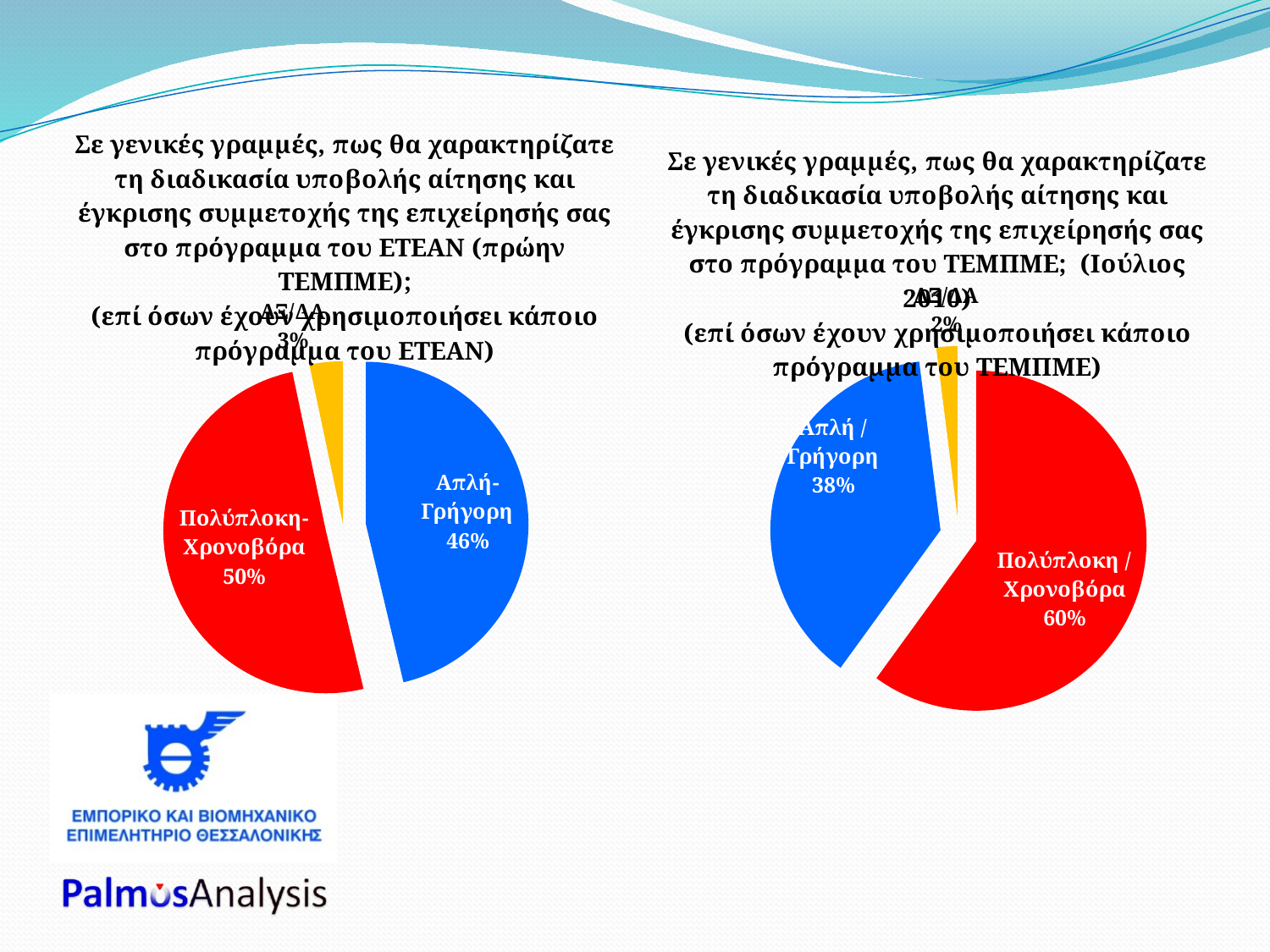
Which is larger: the Απλή-Γρήγορη share in the left chart (ETEAN) or the Απλή / Γρήγορη share in the right chart (ΤΕΜΠΜΕ)? Left chart (ETEAN), 46% In the right pie chart (ΤΕΜΠΜΕ programme), which category has the largest slice? Πολύπλοκη / Χρονοβόρα In the left pie chart (ETEAN programme), what is the difference in percentage points between Πολύπλοκη-Χρονοβόρα and Απλή-Γρήγορη? 4 percentage points What type of chart is used on this slide? Pie chart In the left pie chart (ETEAN programme), which category has the smallest slice? ΔΞ/ΔΑ In the right pie chart (ΤΕΜΠΜΕ programme), what share of respondents answered Απλή / Γρήγορη? 38% How many slices does the left pie chart (ETEAN programme) have? 3 In the left pie chart (ETEAN programme), what share of respondents answered Πολύπλοκη-Χρονοβόρα? 50% In the left pie chart (ETEAN programme), what share is shown for ΔΞ/ΔΑ? 3% In the left pie chart (ETEAN programme), what share of respondents answered Απλή-Γρήγορη? 46% In the right pie chart (ΤΕΜΠΜΕ programme), what share of respondents answered Πολύπλοκη / Χρονοβόρα? 60% In the right pie chart (ΤΕΜΠΜΕ programme), what is the difference in percentage points between Πολύπλοκη / Χρονοβόρα and Απλή / Γρήγορη? 22 percentage points